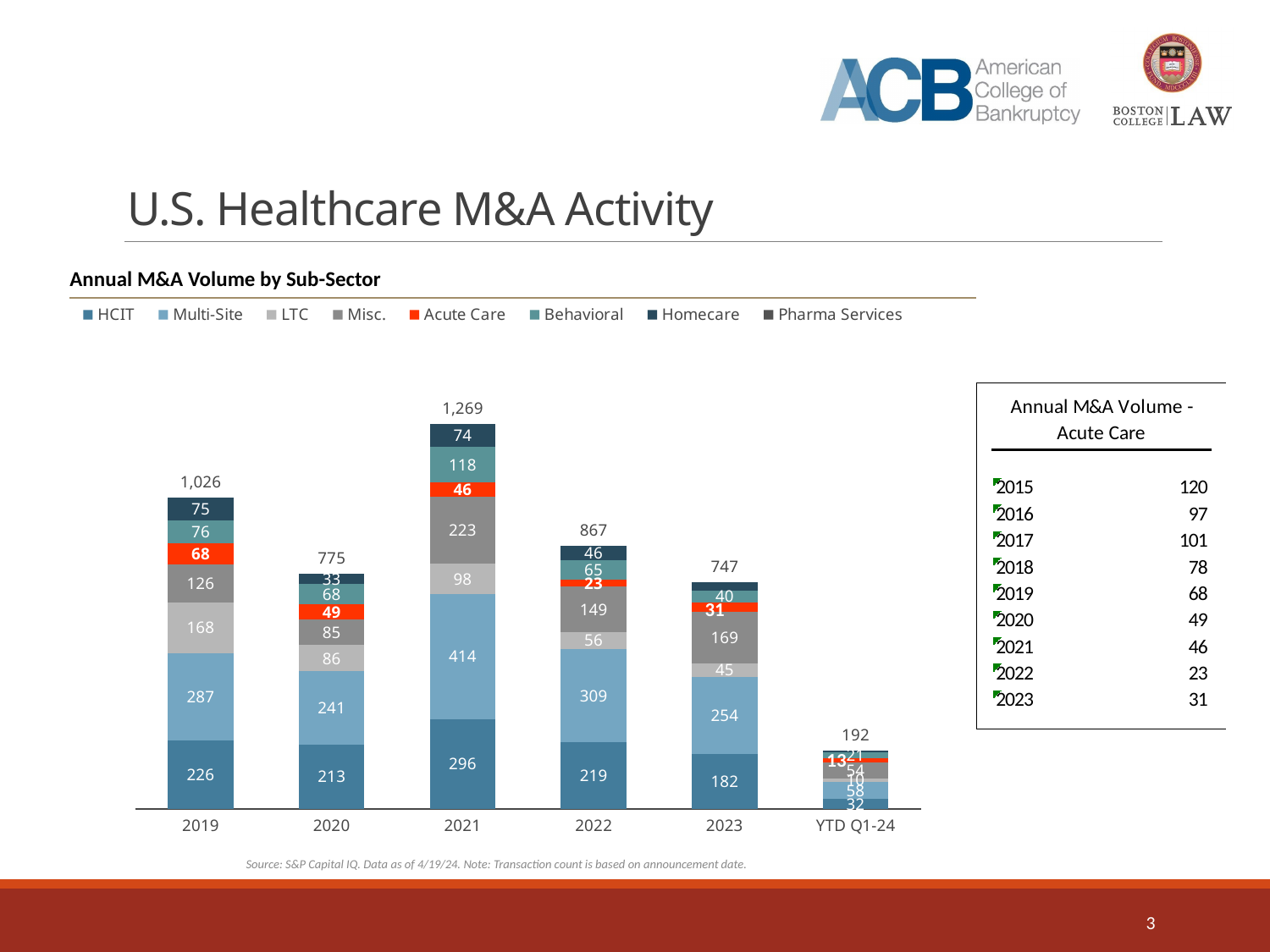
What is the total M&A volume shown for 2021? 1,269 Which period has the lowest total M&A volume in the chart? YTD Q1-24 What is the Acute Care value for 2020 in the stacked bar chart? 49 Do the total M&A volumes rise or fall from 2021 through 2023? Fall Which period has the highest total annual M&A volume in the chart? 2021 What is the difference between the total M&A volume in 2021 and in 2022? 402 Which year has the larger Multi-Site value, 2019 or 2020? 2019 How many time periods are shown along the x axis of the Annual M&A Volume by Sub-Sector chart? 6 What is the Multi-Site value for 2022? 309 How many sub-sector series does the legend of the Annual M&A Volume by Sub-Sector chart list? 8 What type of chart is used to show Annual M&A Volume by Sub-Sector? Stacked bar chart What is the HCIT value for 2021 in the Annual M&A Volume by Sub-Sector chart? 296